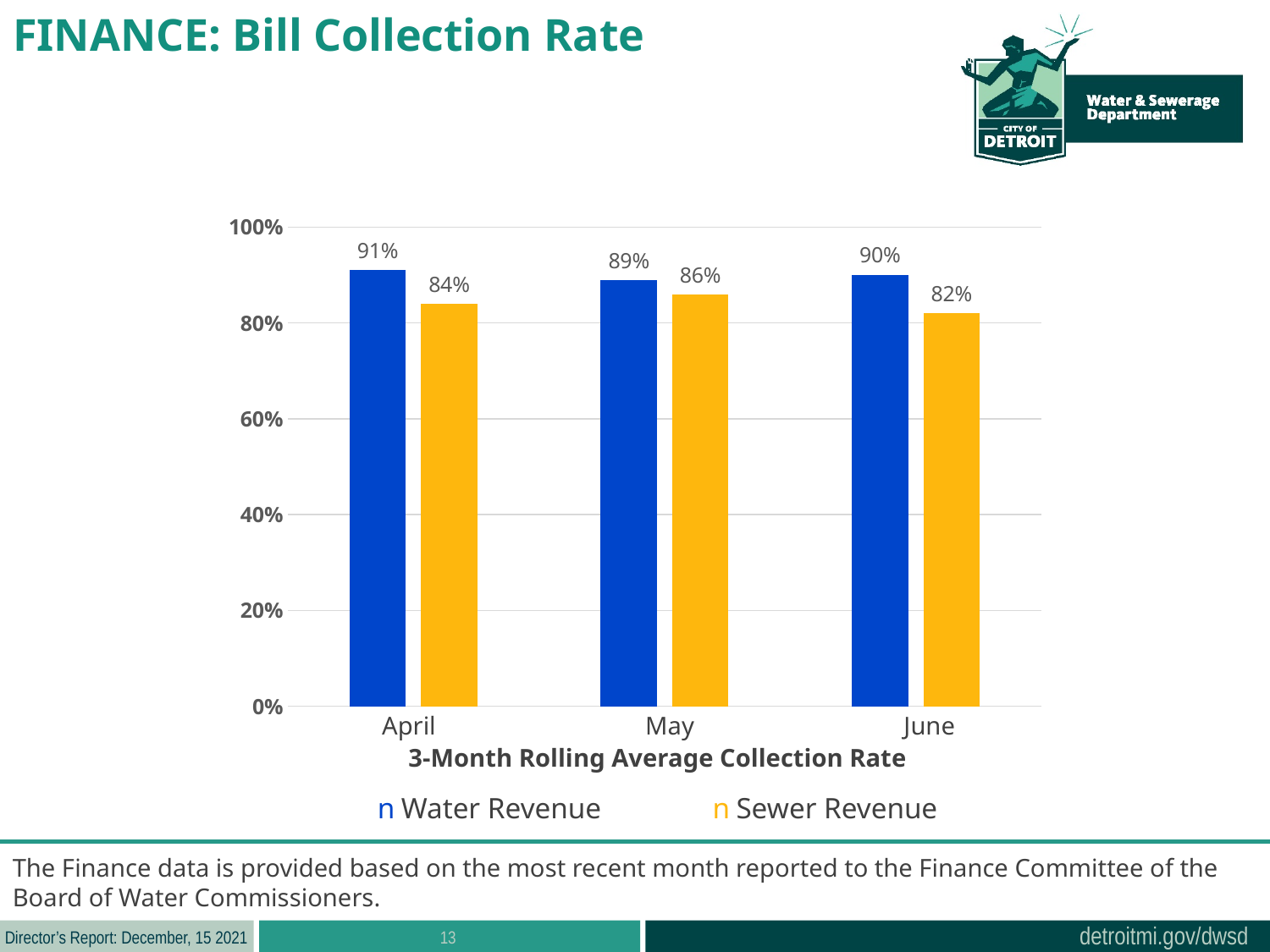
What is the difference between the Water Revenue and Sewer Revenue collection rates in June? 8% What is the Sewer Revenue collection rate for May? 86% What kind of chart is shown on the slide? Bar chart What is the Water Revenue collection rate for April? 91% How many months are shown on the x axis? 3 How many series does the legend list? 2 Which is larger in May, the Water Revenue or the Sewer Revenue collection rate? Water Revenue Is the Sewer Revenue collection rate for April greater or less than 80%? greater What is the Sewer Revenue collection rate for June? 82% Which month has the highest Water Revenue collection rate? April Which month has the lowest Sewer Revenue collection rate? June What is the x-axis title of the chart? 3-Month Rolling Average Collection Rate